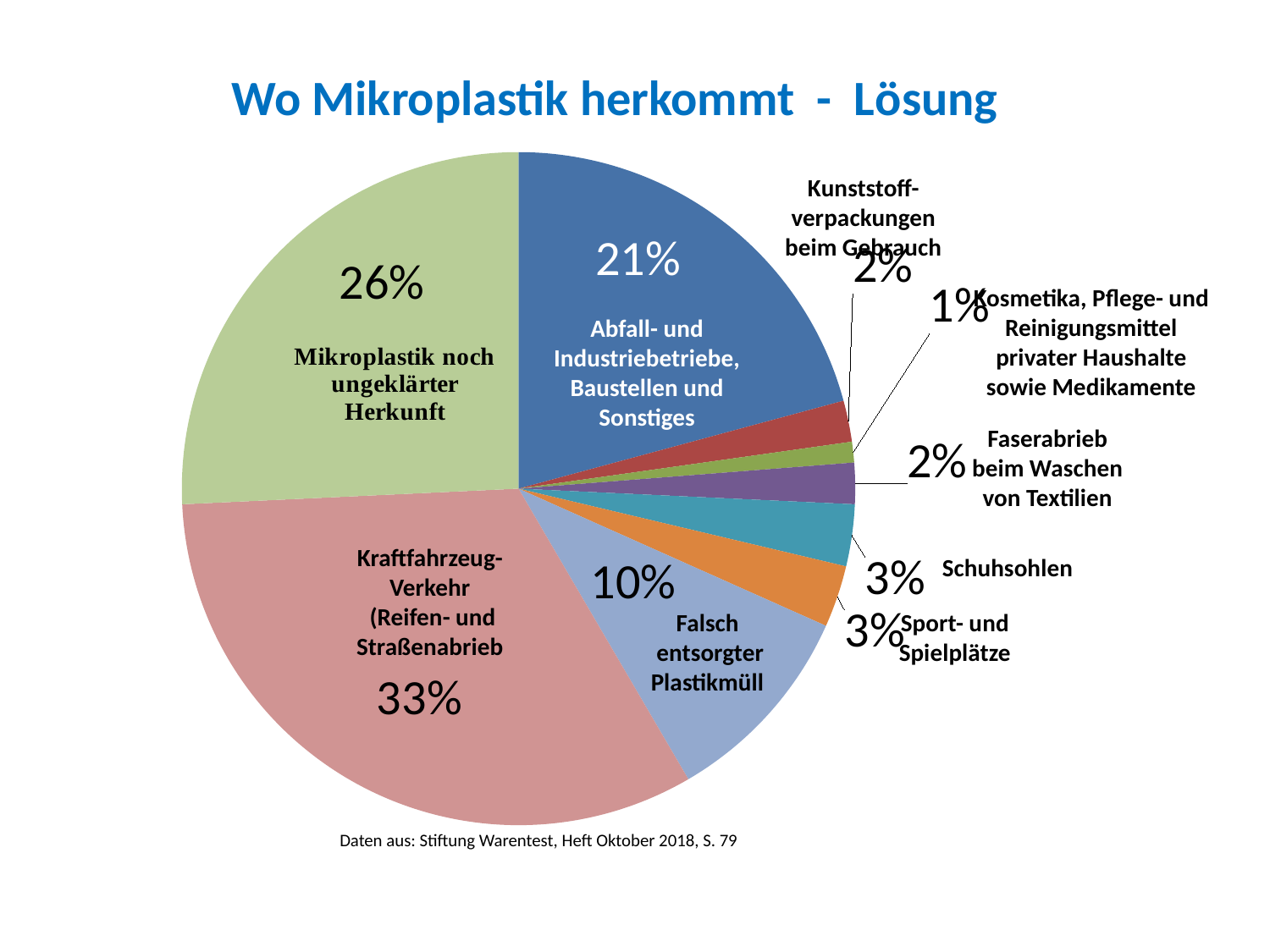
What percentage is shown for Schuhsohlen? 3% What kind of chart is shown on the slide? pie chart Which category has the smallest slice of the pie? Kosmetika, Pflege- und Reinigungsmittel privater Haushalte sowie Medikamente How many slices does the pie chart have? 9 What percentage is shown for Abfall- und Industriebetriebe, Baustellen und Sonstiges? 21% What share of the pie is attributed to Kraftfahrzeug-Verkehr (Reifen- und Straßenabrieb)? 33% What percentage is shown for Mikroplastik noch ungeklärter Herkunft? 26% Which category has the largest slice of the pie? Kraftfahrzeug-Verkehr (Reifen- und Straßenabrieb) What percentage is shown for Falsch entsorgter Plastikmüll? 10% Which is larger: the share for Abfall- und Industriebetriebe, Baustellen und Sonstiges or the share for Falsch entsorgter Plastikmüll? Abfall- und Industriebetriebe, Baustellen und Sonstiges What percentage is shown for Kosmetika, Pflege- und Reinigungsmittel privater Haushalte sowie Medikamente? 1% What is the difference in percentage points between Kraftfahrzeug-Verkehr and Mikroplastik noch ungeklärter Herkunft? 7 percentage points